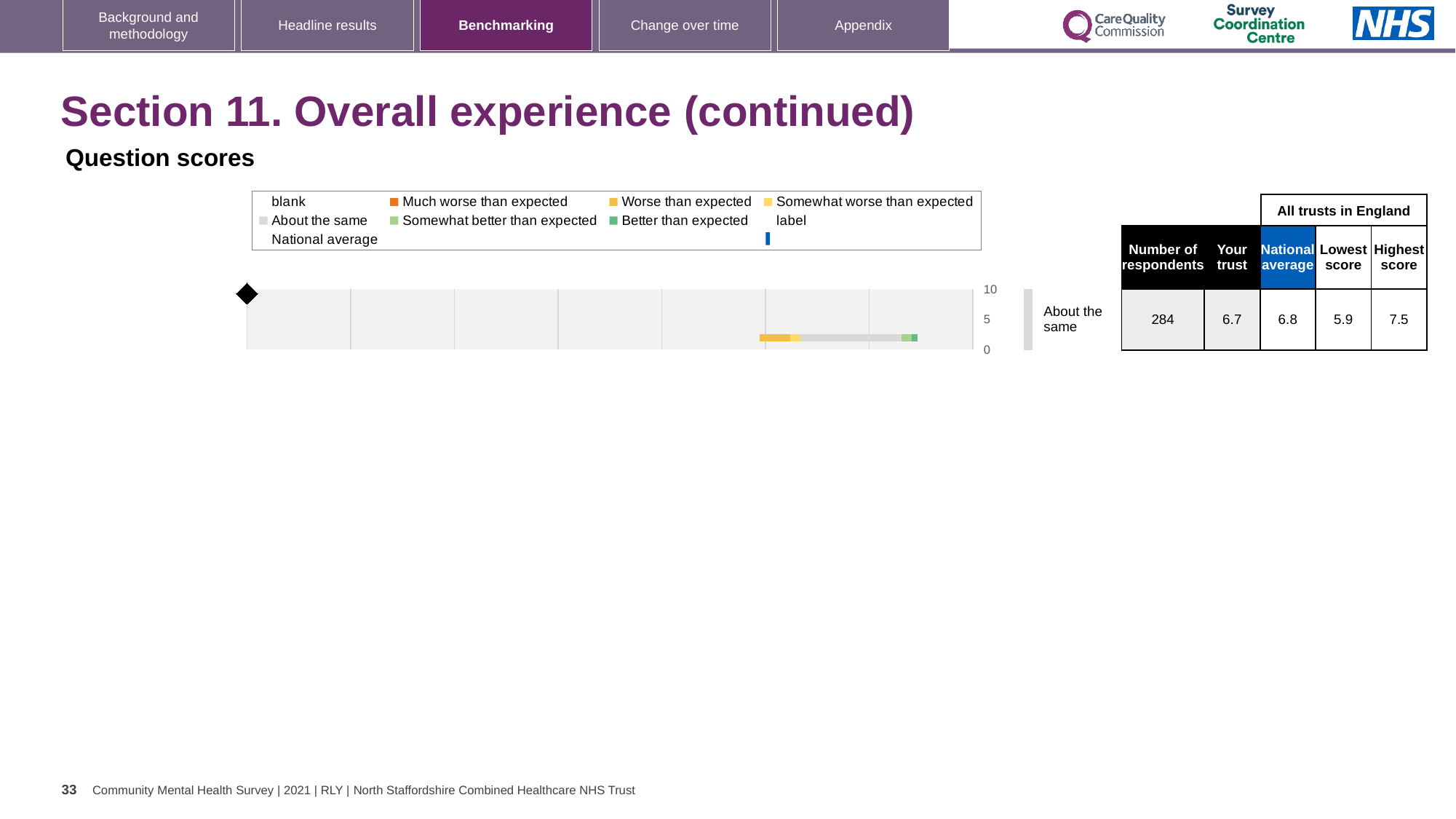
What is the Lowest score among all trusts in England shown for the 'About the same' row? 5.9 Which is larger for the 'About the same' row: the 'Your trust' score or the National average score? National average What is the Highest score among all trusts in England shown for the 'About the same' row? 7.5 What is the National average score shown for the 'About the same' row? 6.8 What is the difference between the Highest score and the Lowest score shown for the 'About the same' row? 1.6 What category label is shown for the plotted bar? About the same What is the highest value shown on the chart's vertical axis? 10 What kind of chart is shown on the slide? bar chart What is the 'Your trust' score shown for the 'About the same' row? 6.7 How many bars are plotted in the chart? 1 How many entries does the chart legend list? 9 How many respondents are shown for the 'About the same' row? 284